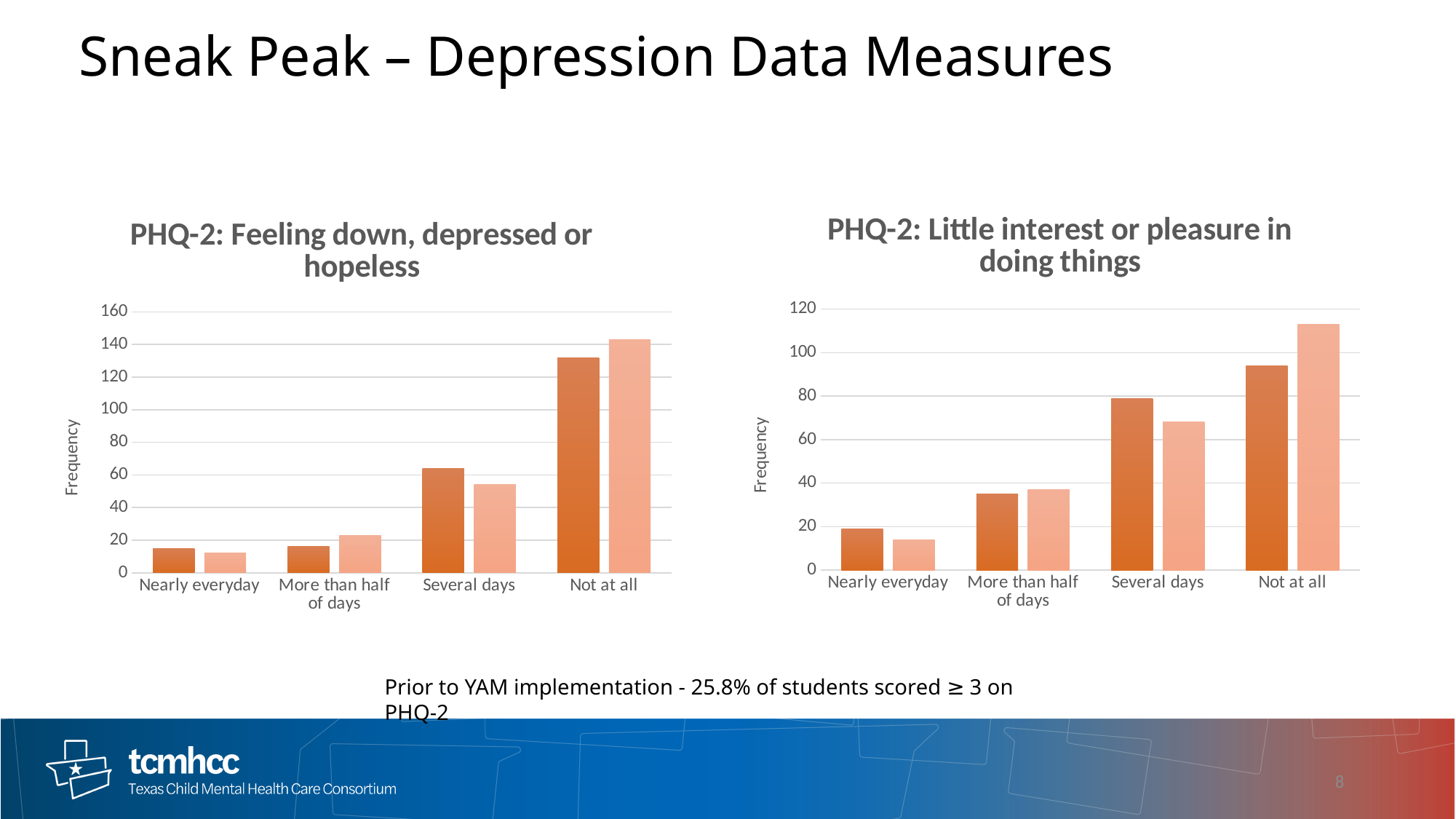
In the right chart 'PHQ-2: Little interest or pleasure in doing things', is the value of the light orange bar for 'Not at all' greater or less than 100? greater In the right chart 'PHQ-2: Little interest or pleasure in doing things', which is larger for 'Several days': the dark orange bar or the light orange bar? the dark orange bar What is the highest value shown on the y axis of the right chart 'PHQ-2: Little interest or pleasure in doing things'? 120 In the left chart 'PHQ-2: Feeling down, depressed or hopeless', is the value of the dark orange bar for 'Several days' greater or less than 80? less In the right chart 'PHQ-2: Little interest or pleasure in doing things', is the value of the dark orange bar for 'Several days' greater or less than 60? greater In the left chart 'PHQ-2: Feeling down, depressed or hopeless', which category has the highest bars? Not at all In the right chart 'PHQ-2: Little interest or pleasure in doing things', which category has the lowest bars? Nearly everyday What is the label on the y axis of the left chart 'PHQ-2: Feeling down, depressed or hopeless'? Frequency What kind of chart is the left chart titled 'PHQ-2: Feeling down, depressed or hopeless'? bar chart How many categories are shown on the x axis of the right chart titled 'PHQ-2: Little interest or pleasure in doing things'? 4 In the left chart 'PHQ-2: Feeling down, depressed or hopeless', do the bar values generally rise or fall moving from 'Nearly everyday' to 'Not at all' along the x axis? rise